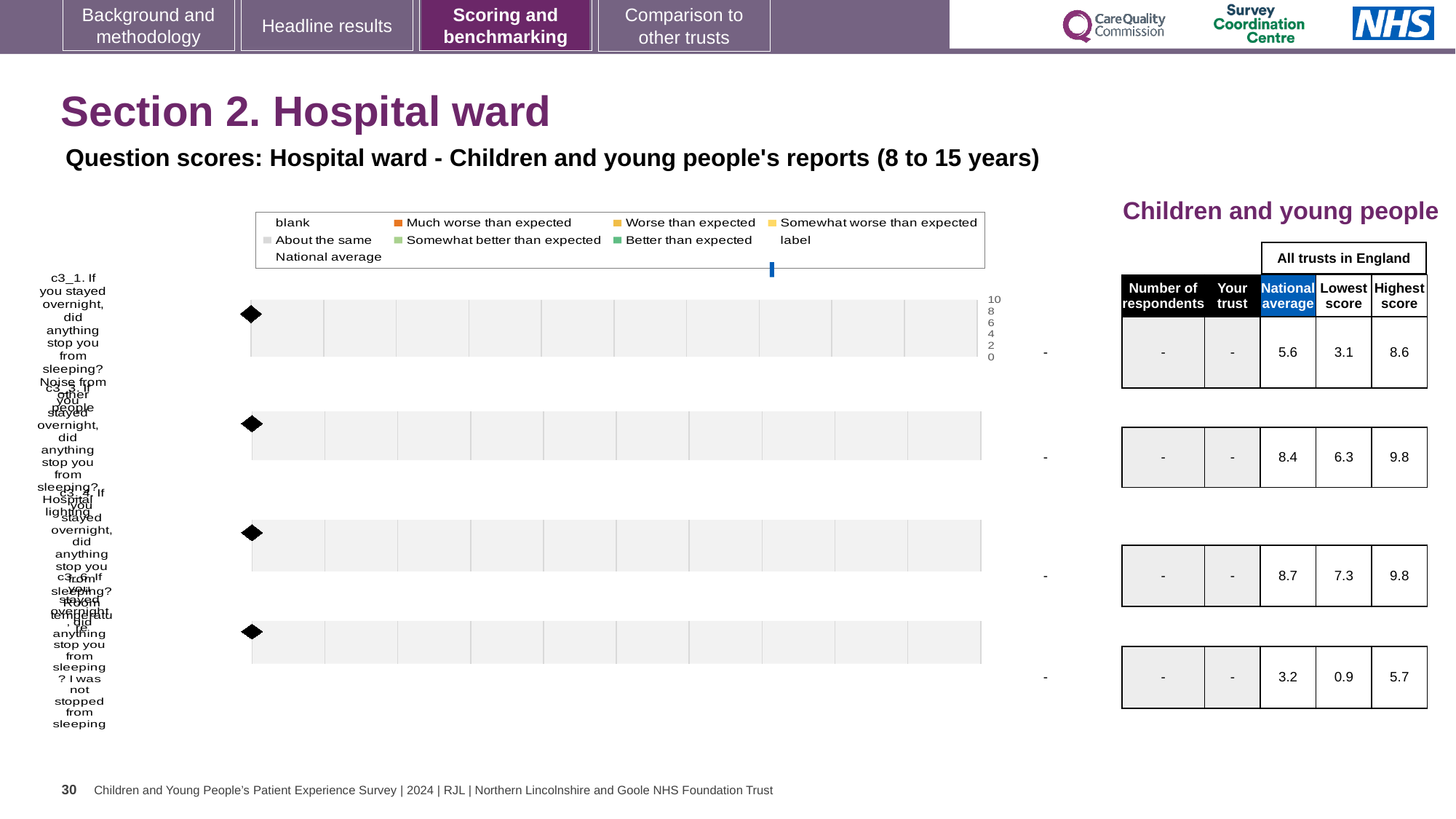
What is the highest value shown on the chart's horizontal axis? 10 Which row of the table has the lowest national average? fourth row (3.2) In the table, what is the national average for the first row? 5.6 Which row of the table has the highest national average? third row (8.7) In the table, what is the difference between the highest score and the lowest score in the first row? 5.5 In the table, what is the highest score for the third row? 9.8 In the table, what is the lowest score for the second row? 6.3 How many rows of scores does the table on the right contain? 4 In the table, what is the national average for the fourth row? 3.2 In the table, is the national average for the second row larger or smaller than the national average for the fourth row? larger What kind of chart is used on this slide? bar chart Which legend entry is shown with an orange marker? Much worse than expected